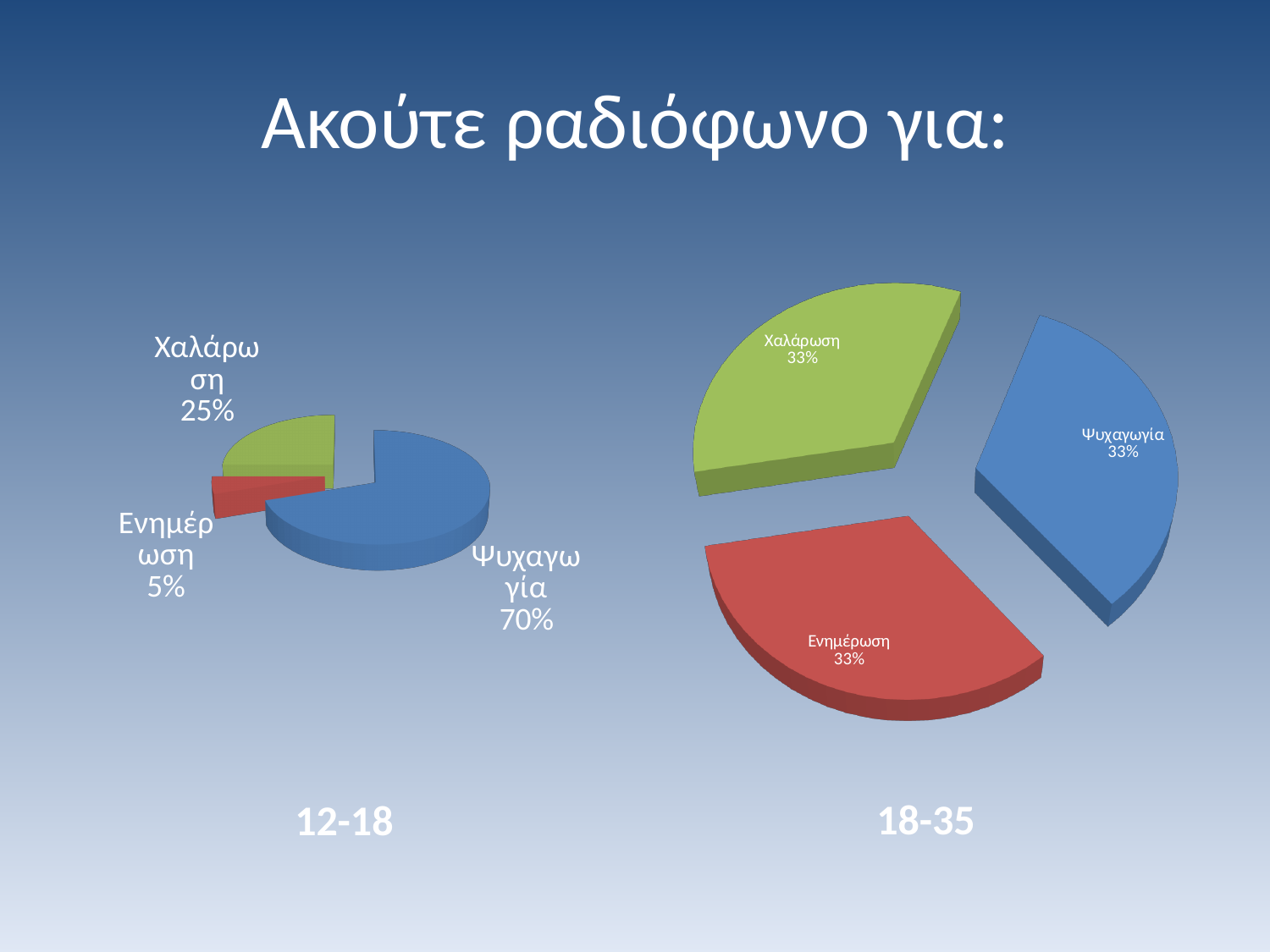
How many slices does the 18-35 chart have? 3 In the 12-18 chart, which category has the smallest slice? Ενημέρωση In the 12-18 chart, what share does Ψυχαγωγία have? 70% In the 18-35 chart, what share does Ενημέρωση have? 33% In the 12-18 chart, what is the difference between the shares of Ψυχαγωγία and Χαλάρωση? 45% In the 12-18 chart, what share does Χαλάρωση have? 25% What is the title of the slide containing the two charts? Ακούτε ραδιόφωνο για: In the 12-18 chart, which is larger, Χαλάρωση or Ενημέρωση? Χαλάρωση In the 12-18 chart, which category has the largest slice? Ψυχαγωγία What type of chart is the 12-18 chart? Pie chart